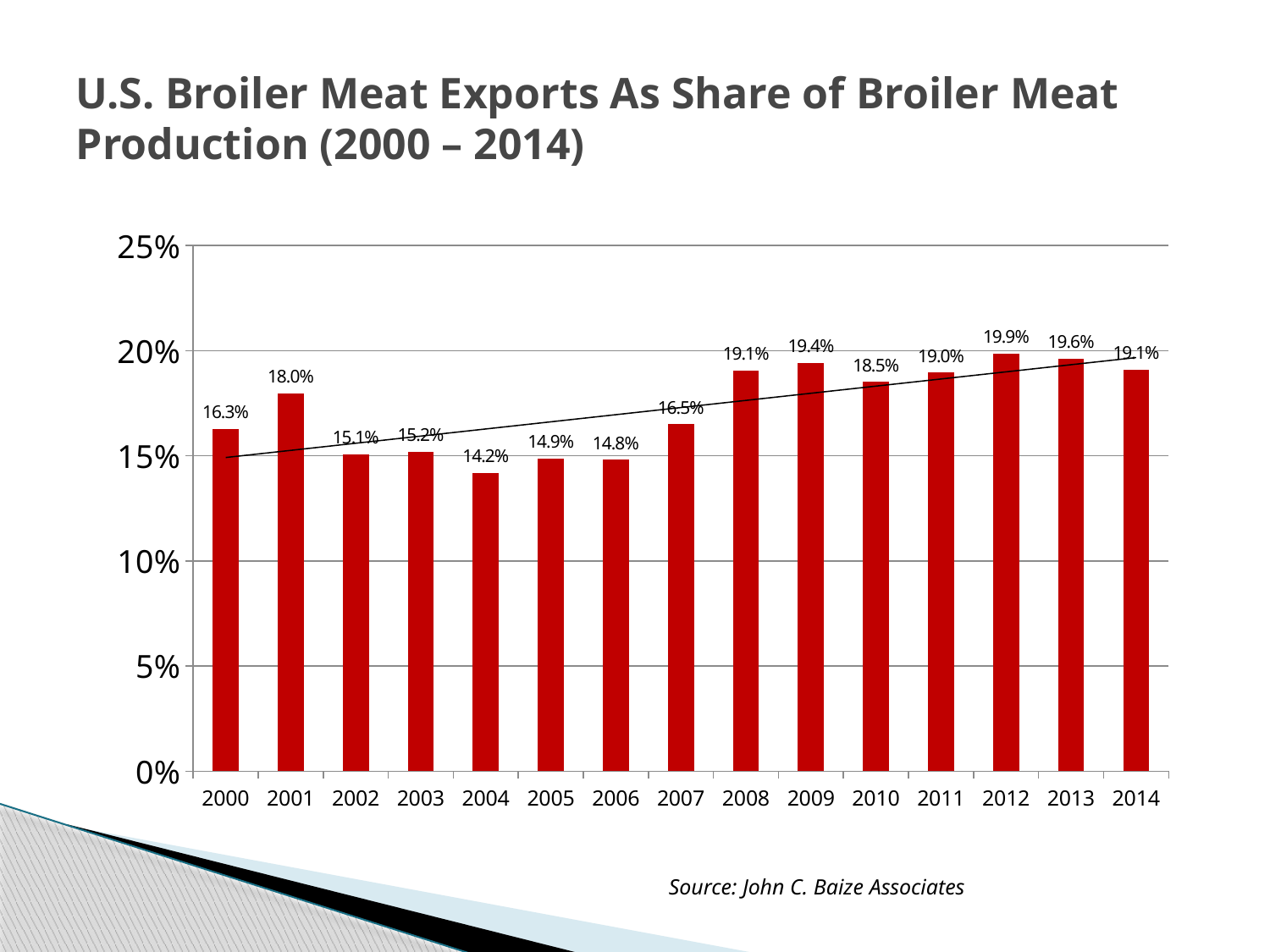
What is the value for 2012? 19.9% What kind of chart is this? bar chart What is the value for 2000? 16.3% What is the source cited below the chart? John C. Baize Associates Which year has the highest value? 2012 How many years are shown on the x axis? 15 Which is larger, the value for 2001 or the value for 2007? 2001 Is the value for 2009 greater or less than 15%? greater What is the value for 2004? 14.2% Do the values generally rise or fall from 2000 to 2014? rise What is the difference between the values for 2012 and 2004? 5.7% Which year has the lowest value? 2004